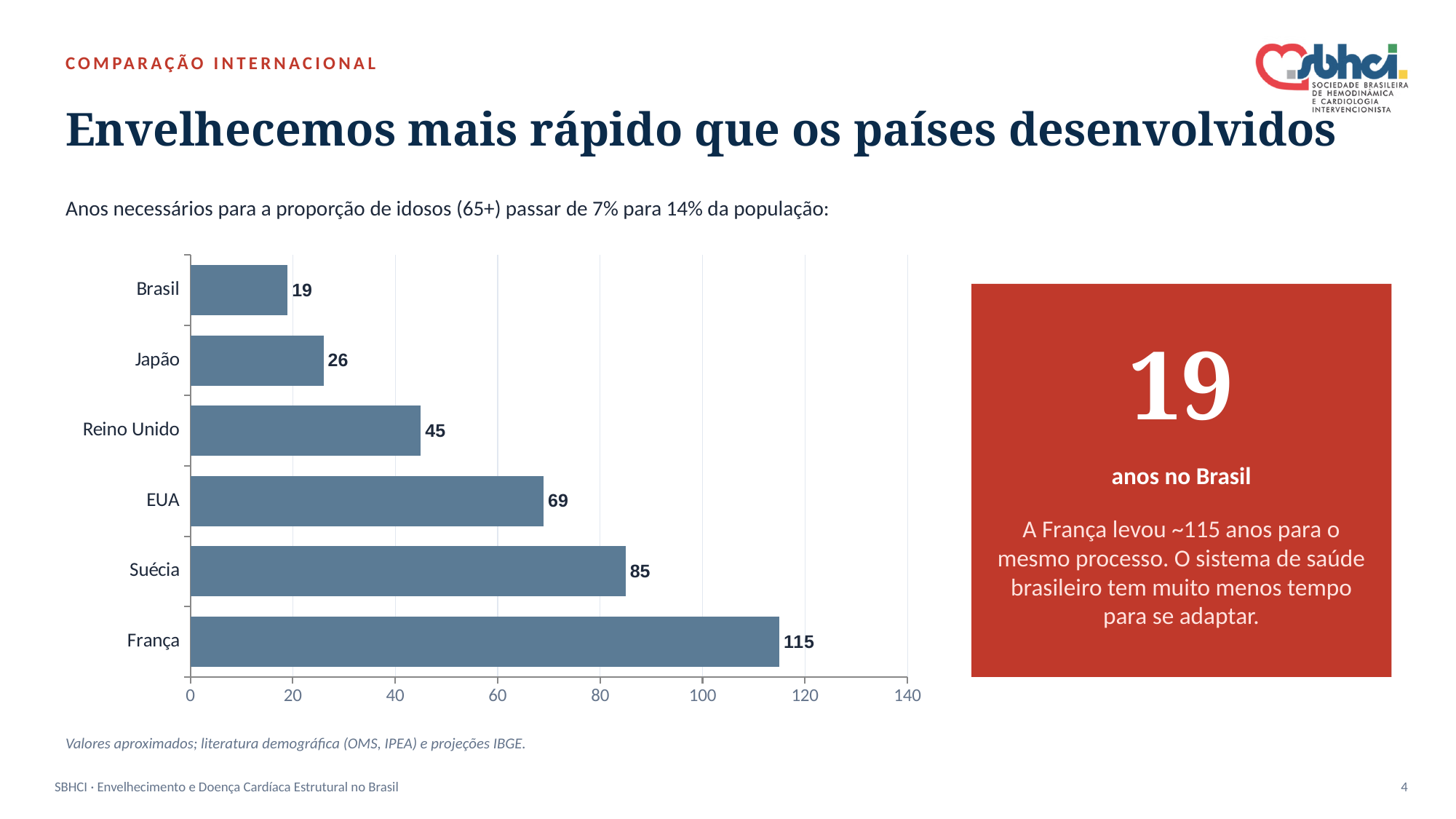
How many years does the chart show for Brasil? 19 How many countries are shown in the chart? 6 What is the difference between the values for França and Brasil? 96 Is the value for França greater or less than 100? greater What is the value shown for Suécia? 85 What kind of chart is shown on the slide? Bar chart Which country has the lowest value in the chart? Brasil What is the value shown for Reino Unido? 45 Which country has the highest value in the chart? França Which has a larger value, Suécia or EUA? Suécia What is the difference between the values for EUA and Japão? 43 What is the maximum value shown on the horizontal axis of the chart? 140